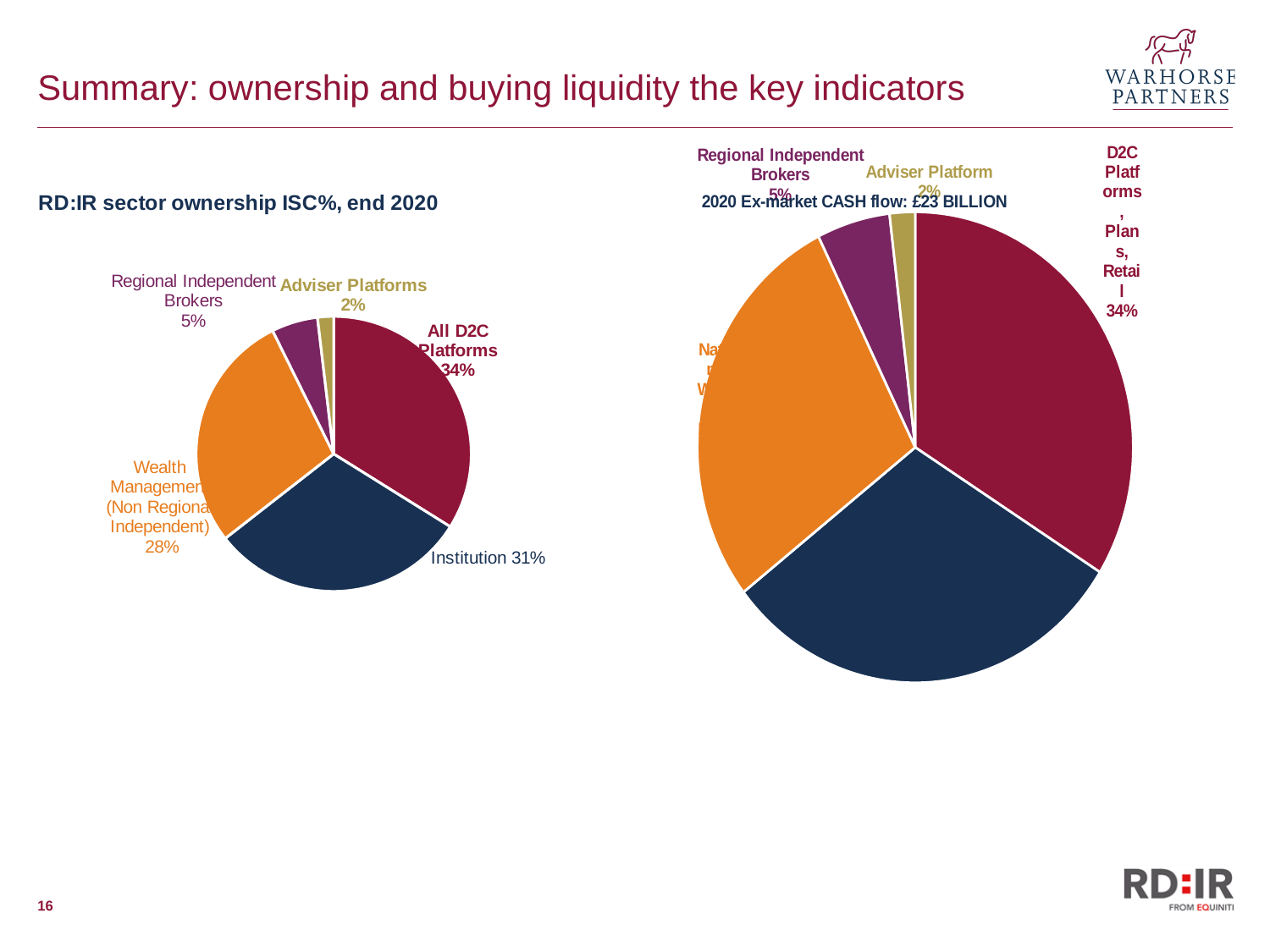
In the 'RD:IR sector ownership ISC%, end 2020' chart, what share does Wealth Management (Non Regional Independent) hold? 28% How many slices does the 'RD:IR sector ownership ISC%, end 2020' pie chart have? 5 In the 'RD:IR sector ownership ISC%, end 2020' chart, which is larger: Institution or Wealth Management (Non Regional Independent)? Institution In the 'RD:IR sector ownership ISC%, end 2020' chart, which category has the smallest share? Adviser Platforms In the '2020 Ex-market CASH flow: £23 BILLION' chart on the right, what share do Regional Independent Brokers hold? 5% In the 'RD:IR sector ownership ISC%, end 2020' chart, what is the difference in percentage points between All D2C Platforms and Institution? 3 percentage points In the 'RD:IR sector ownership ISC%, end 2020' chart, what share do Adviser Platforms hold? 2% In the 'RD:IR sector ownership ISC%, end 2020' chart, which category has the largest share? All D2C Platforms In the 'RD:IR sector ownership ISC%, end 2020' chart, what share does Institution hold? 31% What type of chart is used on the left of the slide for 'RD:IR sector ownership ISC%, end 2020'? Pie chart In the 'RD:IR sector ownership ISC%, end 2020' chart, what share do Regional Independent Brokers hold? 5% In the 'RD:IR sector ownership ISC%, end 2020' chart, what share does All D2C Platforms hold? 34%